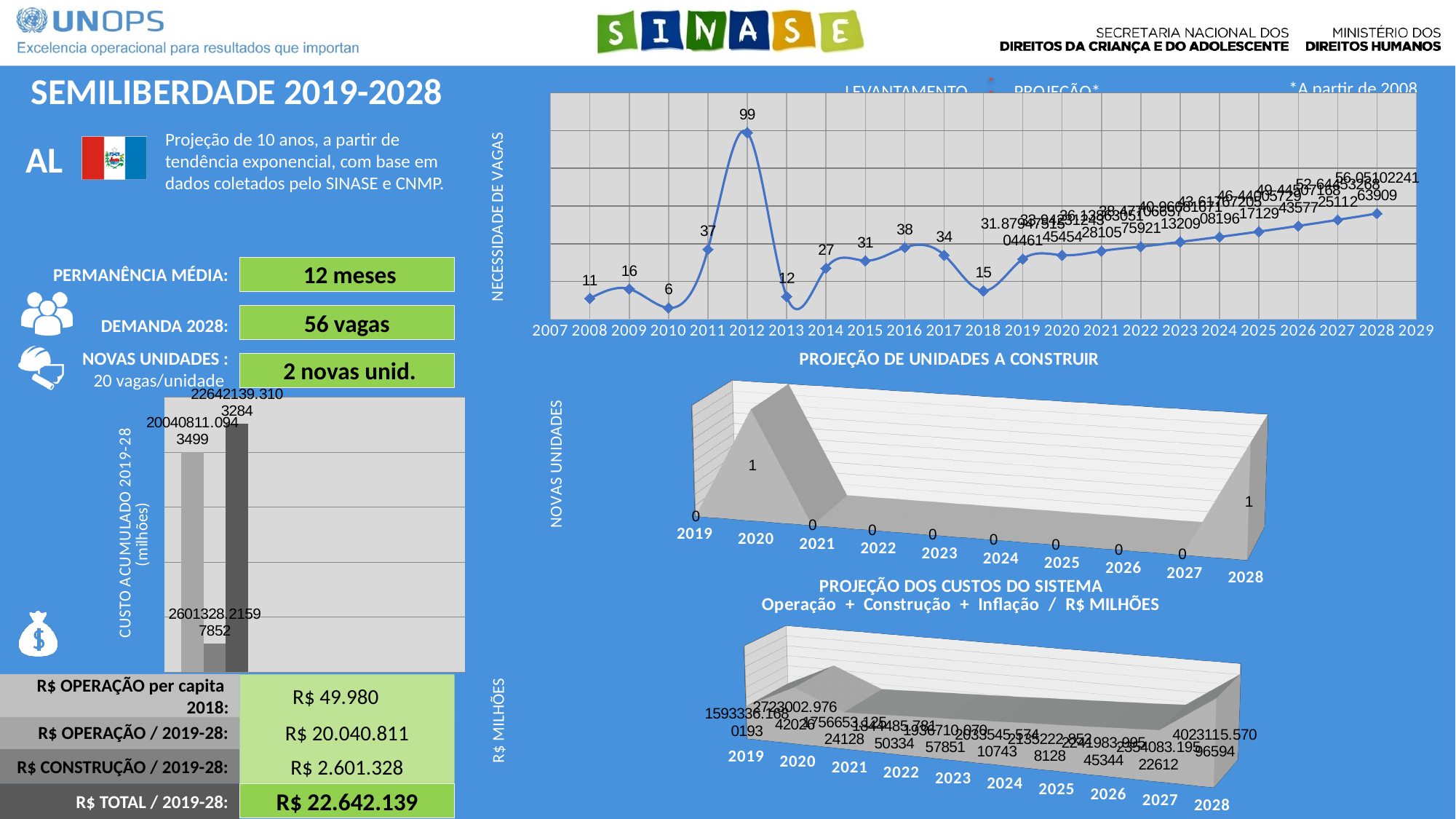
In the NECESSIDADE DE VAGAS line chart, what is the value for 2018? 15 In the NECESSIDADE DE VAGAS line chart, what is the value for 2012? 99 In the NECESSIDADE DE VAGAS line chart, which year has the lowest value? 2010 In the NECESSIDADE DE VAGAS line chart, what is the value for 2011? 37 In the PROJEÇÃO DE UNIDADES A CONSTRUIR chart, what is the value for 2020? 1 What kind of chart is the NECESSIDADE DE VAGAS chart? line chart In the NECESSIDADE DE VAGAS line chart, what is the difference between the values for 2012 and 2011? 62 How many years are shown on the x axis of the PROJEÇÃO DE UNIDADES A CONSTRUIR chart? 10 In the NECESSIDADE DE VAGAS line chart, which is larger, the value for 2016 or the value for 2017? 2016 In the PROJEÇÃO DE UNIDADES A CONSTRUIR chart, what is the value for 2024? 0 In the NECESSIDADE DE VAGAS line chart, which year has the highest value? 2012